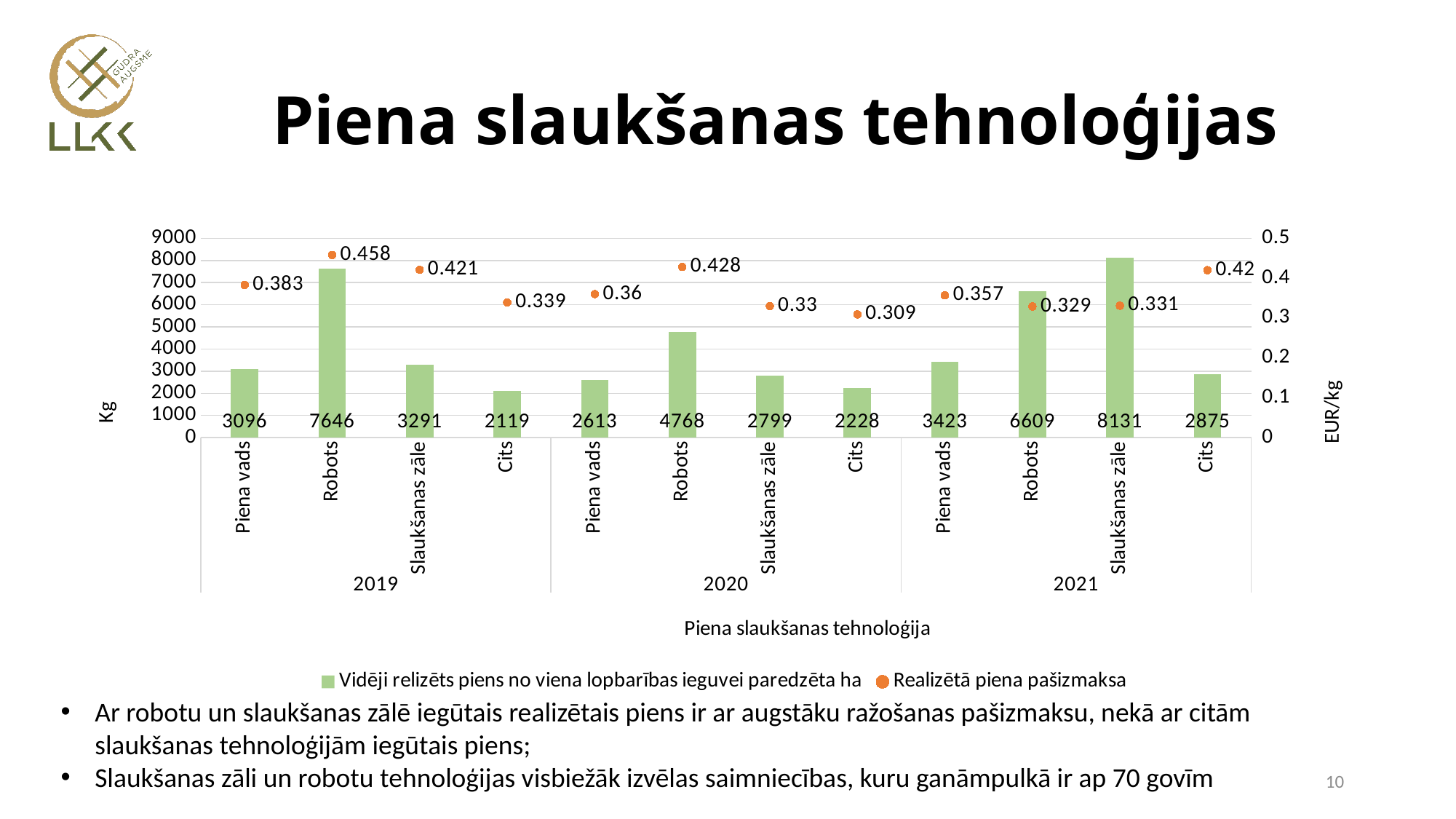
Which category and year has the lowest Realizētā piena pašizmaksa value? Cits, 2020 What is the difference between the bar values for Robots in 2019 and Robots in 2020? 2878 Which category and year has the lowest bar value? Cits, 2019 What is the value of the bar for Cits in 2020? 2228 Which category and year has the highest Realizētā piena pašizmaksa value? Robots, 2019 Which has a larger bar value: Piena vads in 2021 or Slaukšanas zāle in 2019? Piena vads in 2021 Which category and year has the highest bar value? Slaukšanas zāle, 2021 What is the Realizētā piena pašizmaksa value for Slaukšanas zāle in 2021? 0.331 How many series does the legend list? 2 What is the value of the bar for Robots in 2019? 7646 How many bars are plotted in the chart? 12 What is the label of the right-hand vertical axis? EUR/kg